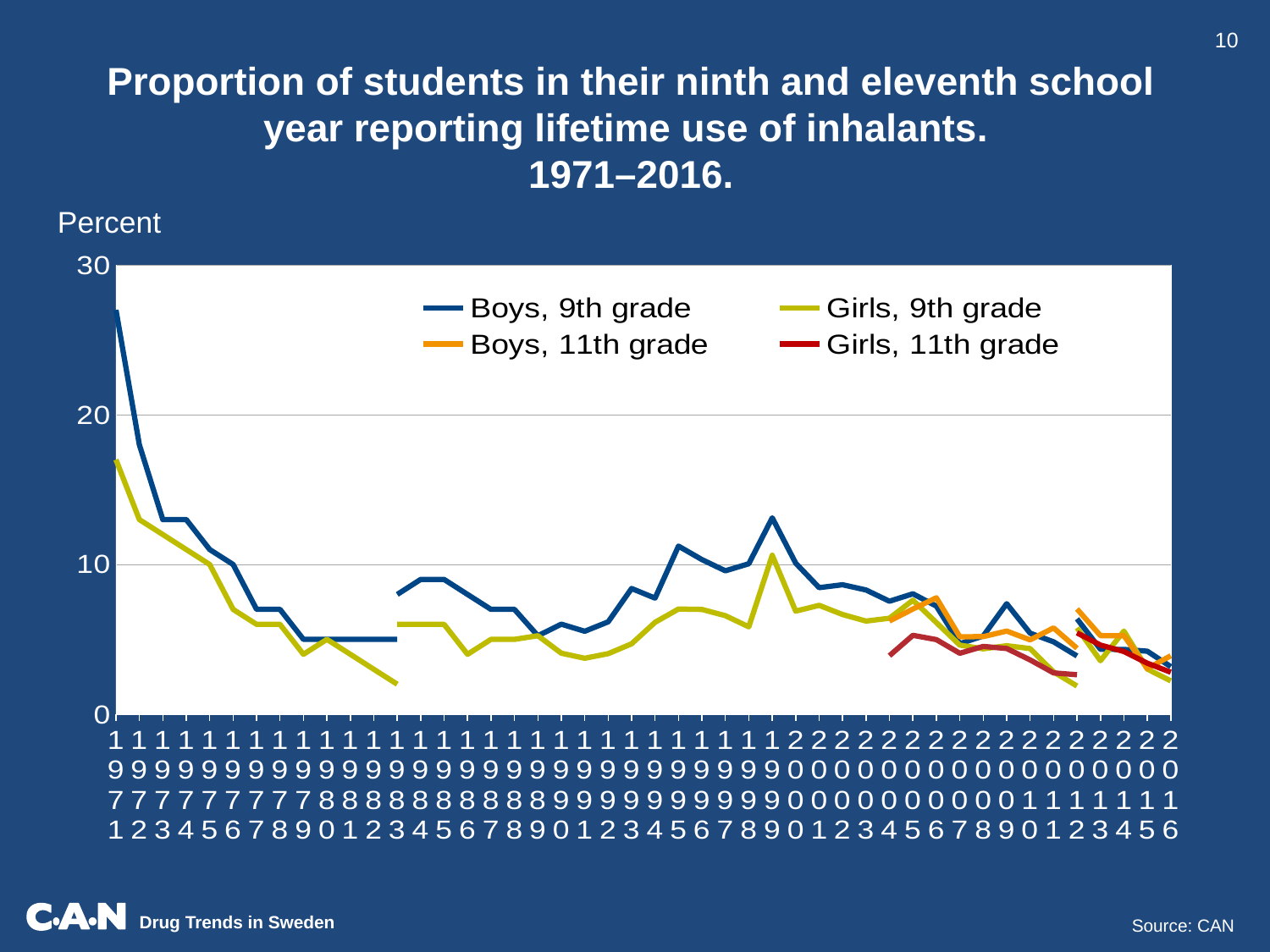
Is the value for Boys, 9th grade in 2016 greater or less than 10? less What kind of chart is shown on the slide? Line chart In which year does the Boys, 9th grade series reach its highest value? 1971 In 1971, which is larger: the value for Boys, 9th grade or Girls, 9th grade? Boys, 9th grade How many series does the legend list? 4 Does the Boys, 9th grade series rise or fall between 1971 and 1980? Fall What source is cited for the chart? CAN What unit label is shown above the y axis? Percent Is the value for Boys, 9th grade in 1999 greater or less than 10? greater Is the value for Girls, 9th grade in 1971 greater or less than 20? less Which series reaches the highest value anywhere on the chart? Boys, 9th grade